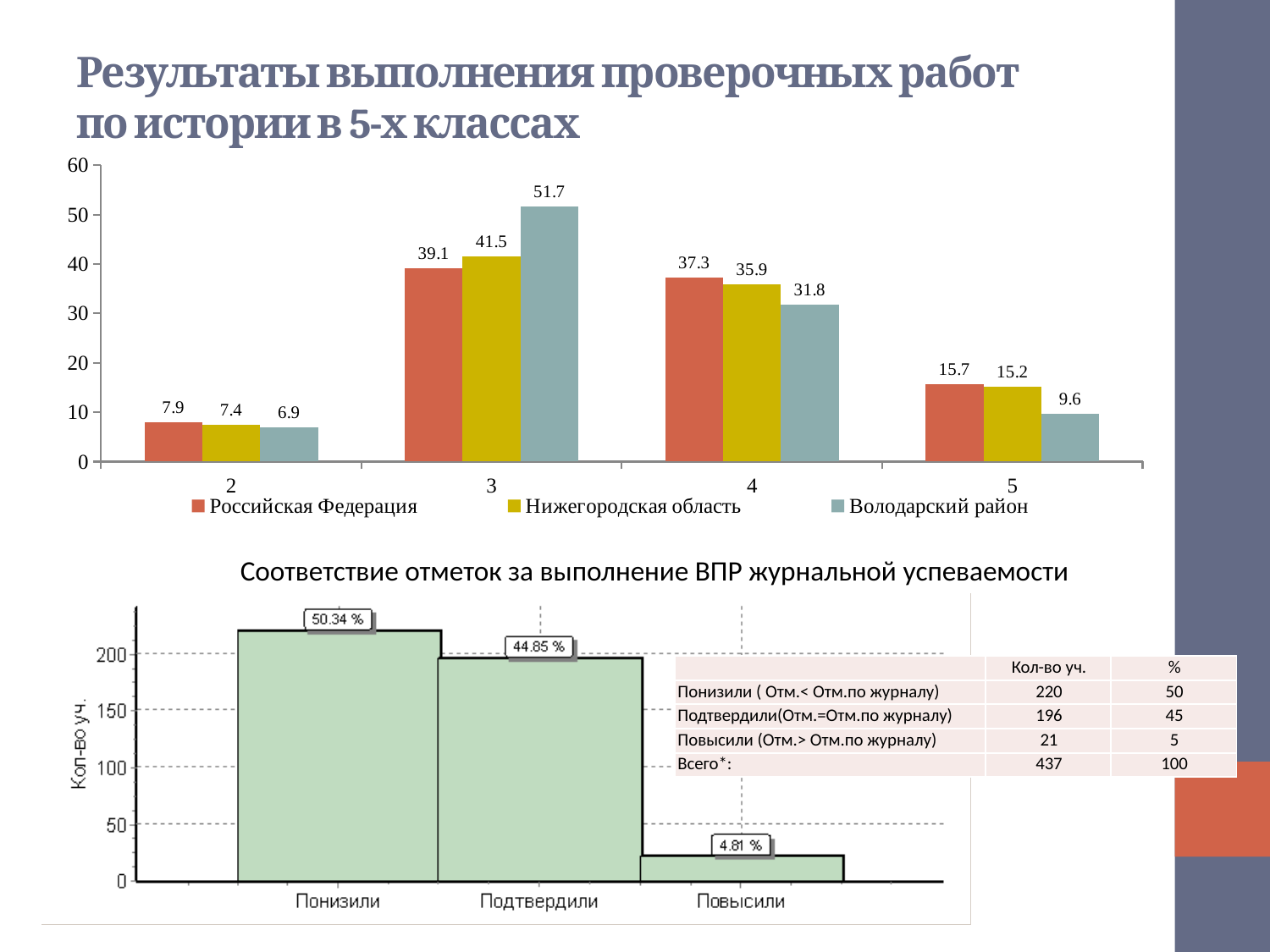
How many series does the legend of the top chart list? 3 In the top chart, which category has the highest value for Володарский район? 3 In the top chart, what is the value for Нижегородская область at category 4? 35.9 In the top chart, what is the value for Российская Федерация at category 3? 39.1 In the bottom chart, what percentage is shown for Подтвердили? 44.85 % What kind of chart is the bottom chart? bar chart In the top chart, at category 4, which is larger: Российская Федерация or Володарский район? Российская Федерация In the bottom chart, which category has the lowest value? Повысили In the top chart, what is the value for Володарский район at category 5? 9.6 How many categories are shown on the x axis of the top chart? 4 In the top chart, which category has the lowest value for Российская Федерация? 2 In the top chart, what is the difference between Володарский район and Российская Федерация at category 3? 12.6